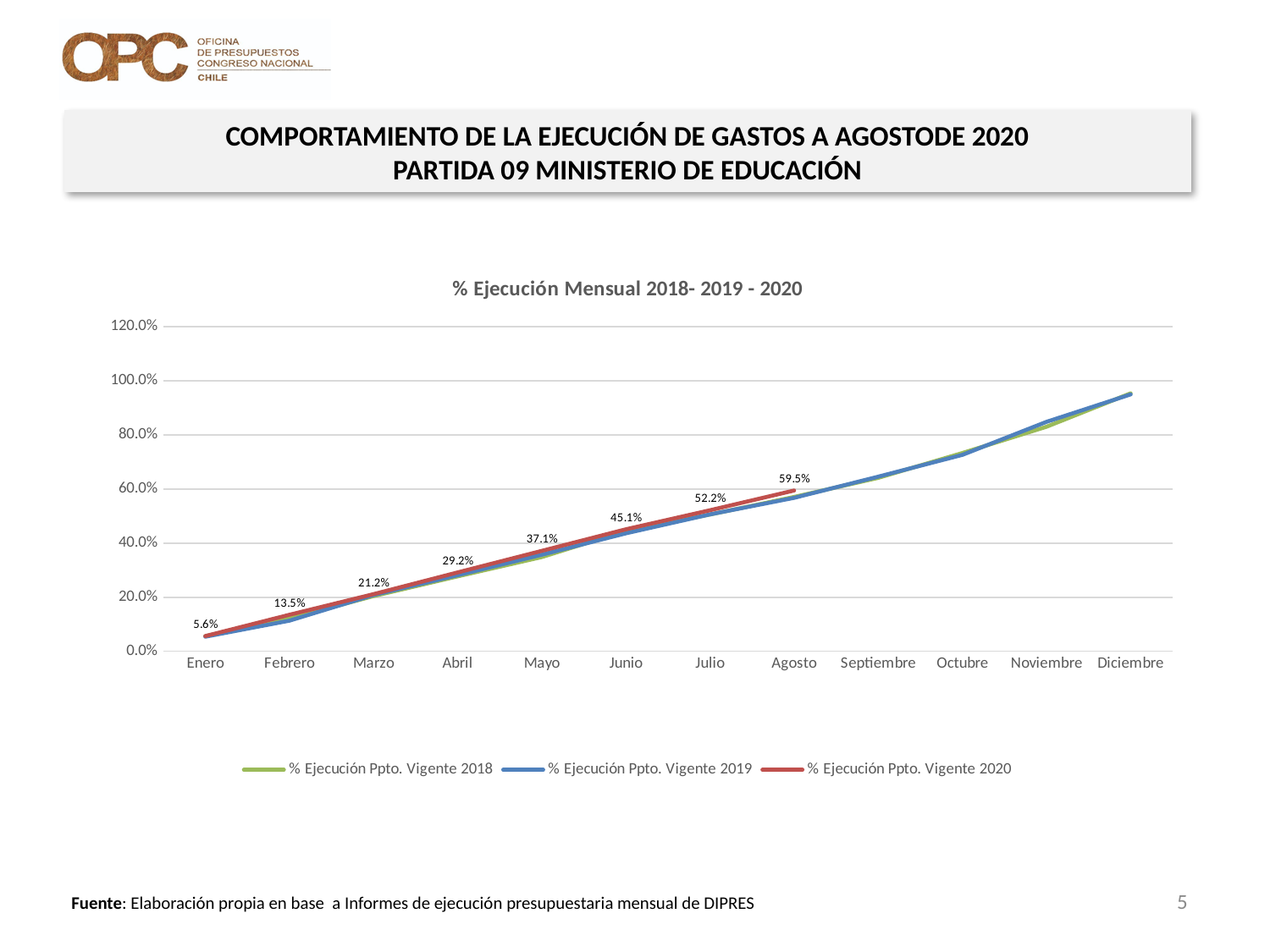
What is the title of the chart? % Ejecución Mensual 2018- 2019 - 2020 What is the value of % Ejecución Ppto. Vigente 2020 for Agosto? 59.5% Is the value of % Ejecución Ppto. Vigente 2019 for Diciembre greater or less than 80.0%? greater What kind of chart is shown on the slide? line chart Does the % Ejecución Ppto. Vigente 2020 series rise or fall from Enero to Agosto? rise What is the difference between the 2020 values for Junio and Enero? 39.5% What is the value of % Ejecución Ppto. Vigente 2020 for Abril? 29.2% How many months are shown on the x axis? 12 Which month has the highest value for % Ejecución Ppto. Vigente 2020? Agosto What is the difference between the 2020 values for Agosto and Julio? 7.3% How many series does the legend list? 3 What is the value of % Ejecución Ppto. Vigente 2020 for Enero? 5.6%